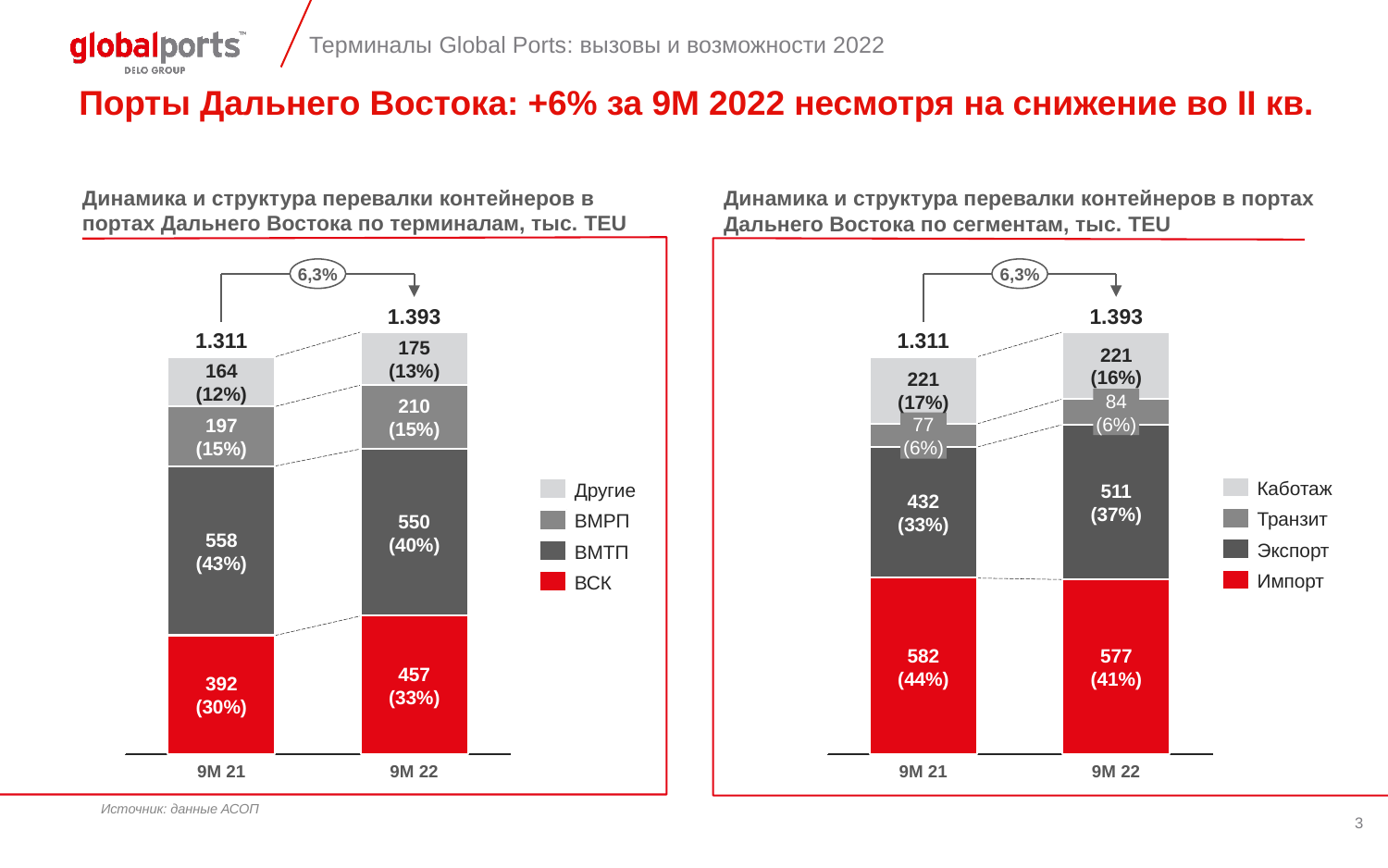
In the right chart (by segments), what share of the 9M 22 total does Каботаж represent? 16% In the right chart (by segments), which segment has the smallest value in 9M 21? Транзит In the right chart (by segments), what is the value for Экспорт in 9M 22? 511 In the left chart (by terminals), which terminal has the largest value in 9M 22? ВМТП In the left chart (by terminals), what is the total of the 9M 21 stacked bar? 1.311 In the right chart (by segments), what is the total of the 9M 22 stacked bar? 1.393 What type of chart is shown on the right side of the slide? Stacked bar chart In the left chart (by terminals), what is the value for ВМТП in 9M 21? 558 In the left chart (by terminals), what is the value for ВСК in 9M 22? 457 In the right chart (by segments), is the Импорт value larger in 9M 21 or 9M 22? 9M 21 In the left chart (by terminals), what is the difference between the ВСК values for 9M 22 and 9M 21? 65 In the left chart (by terminals), how many series does the legend list? 4